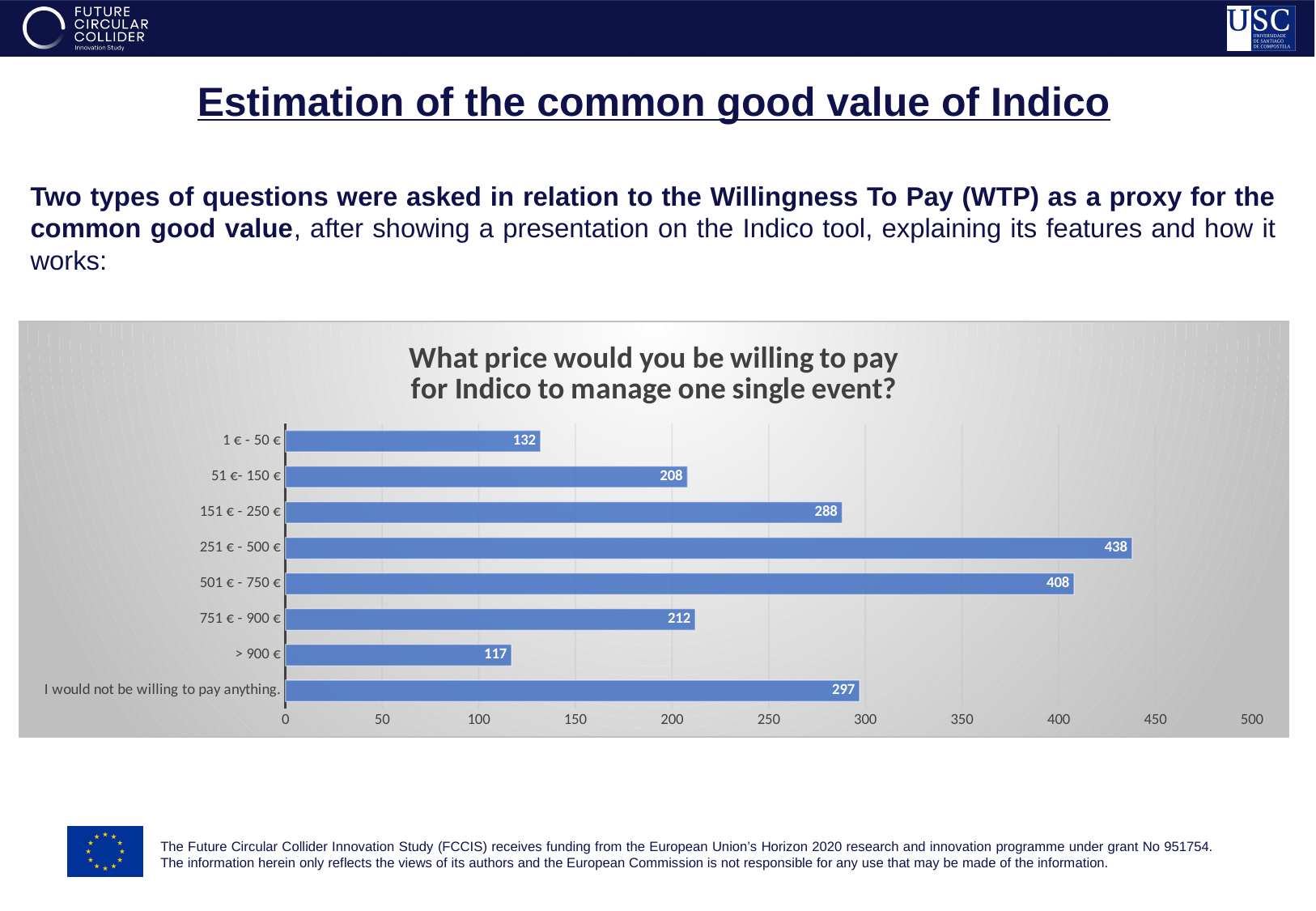
How many categories are shown on the chart? 8 What kind of chart is shown on the slide? Bar chart Is the value for "501 € - 750 €" greater or less than 400? greater What is the value for the "> 900 €" category? 117 What is the difference between the values for "251 € - 500 €" and "501 € - 750 €"? 30 Which category has the lowest value? > 900 € Which is larger, the value for "51 €- 150 €" or the value for "751 € - 900 €"? 751 € - 900 € What is the value for "I would not be willing to pay anything."? 297 What is the value for the "251 € - 500 €" category? 438 What is the title of the chart? What price would you be willing to pay for Indico to manage one single event? What is the difference between the values for "151 € - 250 €" and "1 € - 50 €"? 156 Which category has the highest value? 251 € - 500 €